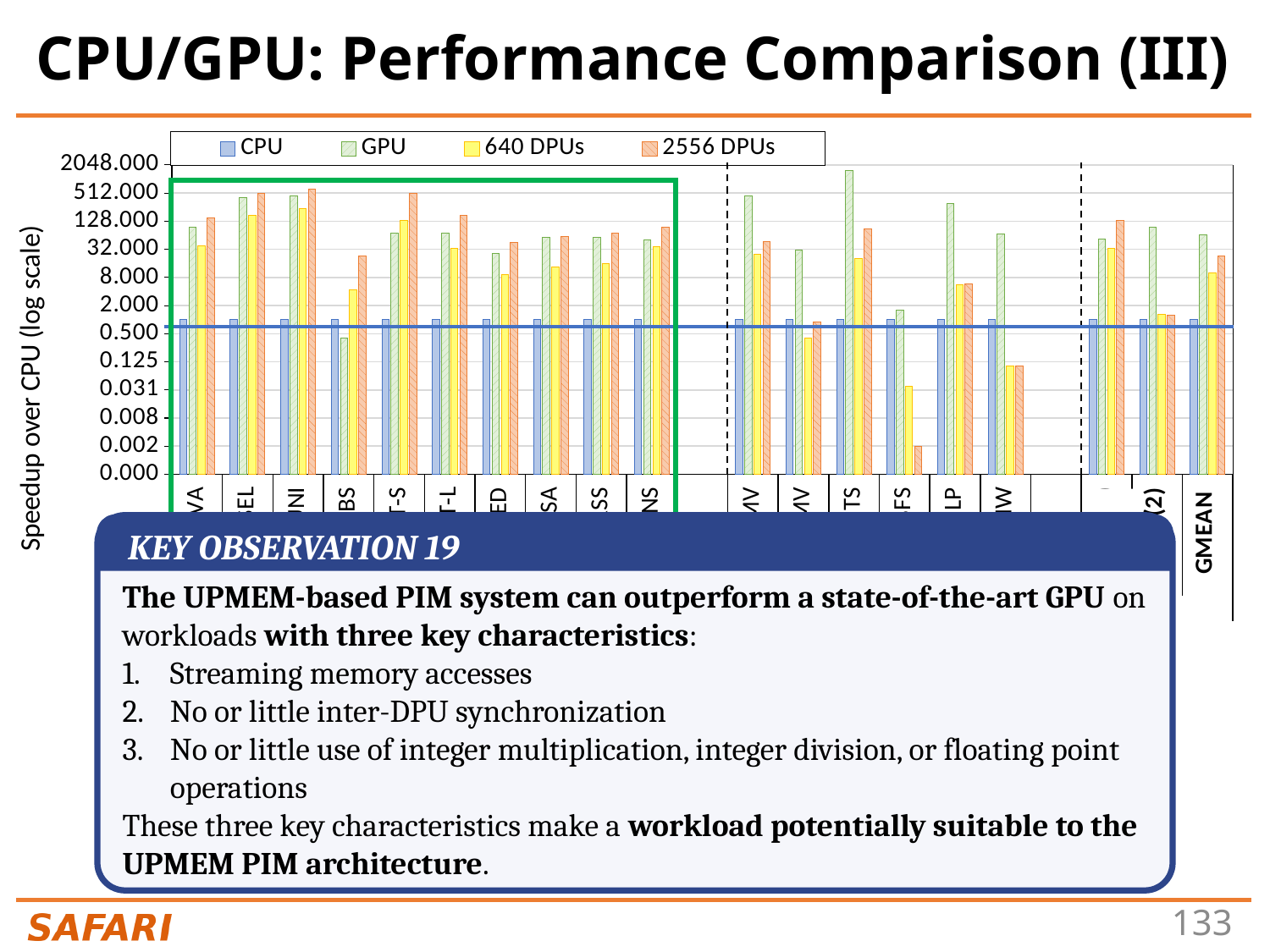
Is the CPU value for GMEAN greater or less than 2.000? less For GMEAN, which is larger: the 2556 DPUs value or the 640 DPUs value? 2556 DPUs Is the CPU value for GMEAN greater or less than 0.500? greater What is the label of the chart's y axis? Speedup over CPU (log scale) How many series does the chart's legend list? 4 Is the 640 DPUs value for GMEAN greater or less than 2.000? greater For GMEAN, which is larger: the GPU value or the 2556 DPUs value? GPU What kind of chart is shown on the slide? bar chart What are the series listed in the chart's legend? CPU, GPU, 640 DPUs, 2556 DPUs For GMEAN, which is larger: the GPU value or the 640 DPUs value? GPU